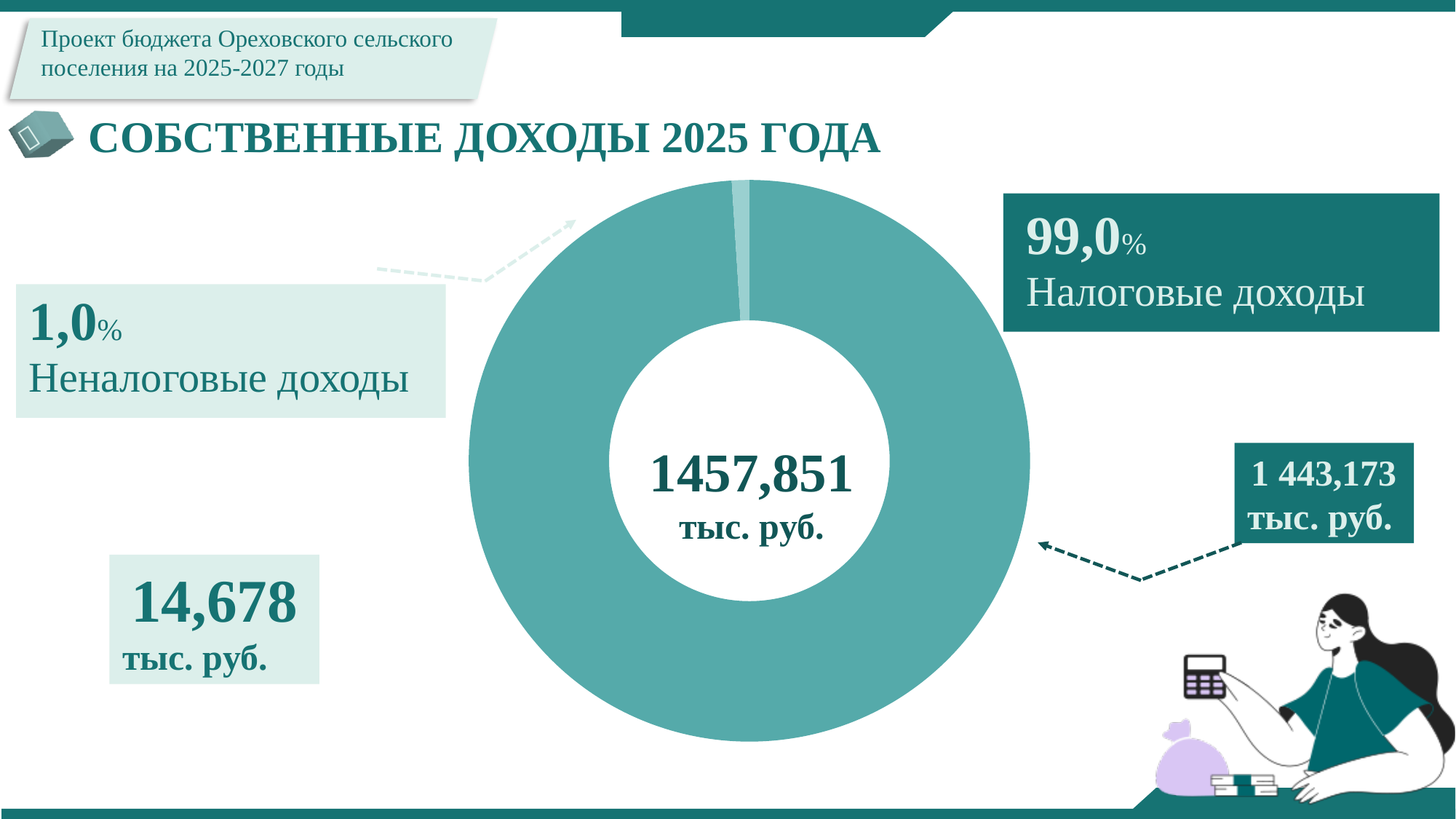
What is the total value shown in the centre of the chart? 1457,851 тыс. руб. What is the value for Неналоговые доходы in тыс. руб.? 14,678 тыс. руб. What is the title of the chart on the slide? СОБСТВЕННЫЕ ДОХОДЫ 2025 ГОДА What is the value for Налоговые доходы in тыс. руб.? 1 443,173 тыс. руб. What kind of chart is shown on the slide? Donut (pie) chart How many categories does the chart show? 2 What share of the chart is Налоговые доходы? 99,0% Which category has the smallest share of the chart? Неналоговые доходы Which is larger, Налоговые доходы or Неналоговые доходы? Налоговые доходы What share of the chart is Неналоговые доходы? 1,0% What is the difference in percentage points between Налоговые доходы and Неналоговые доходы? 98,0 percentage points Which category has the largest share of the chart? Налоговые доходы